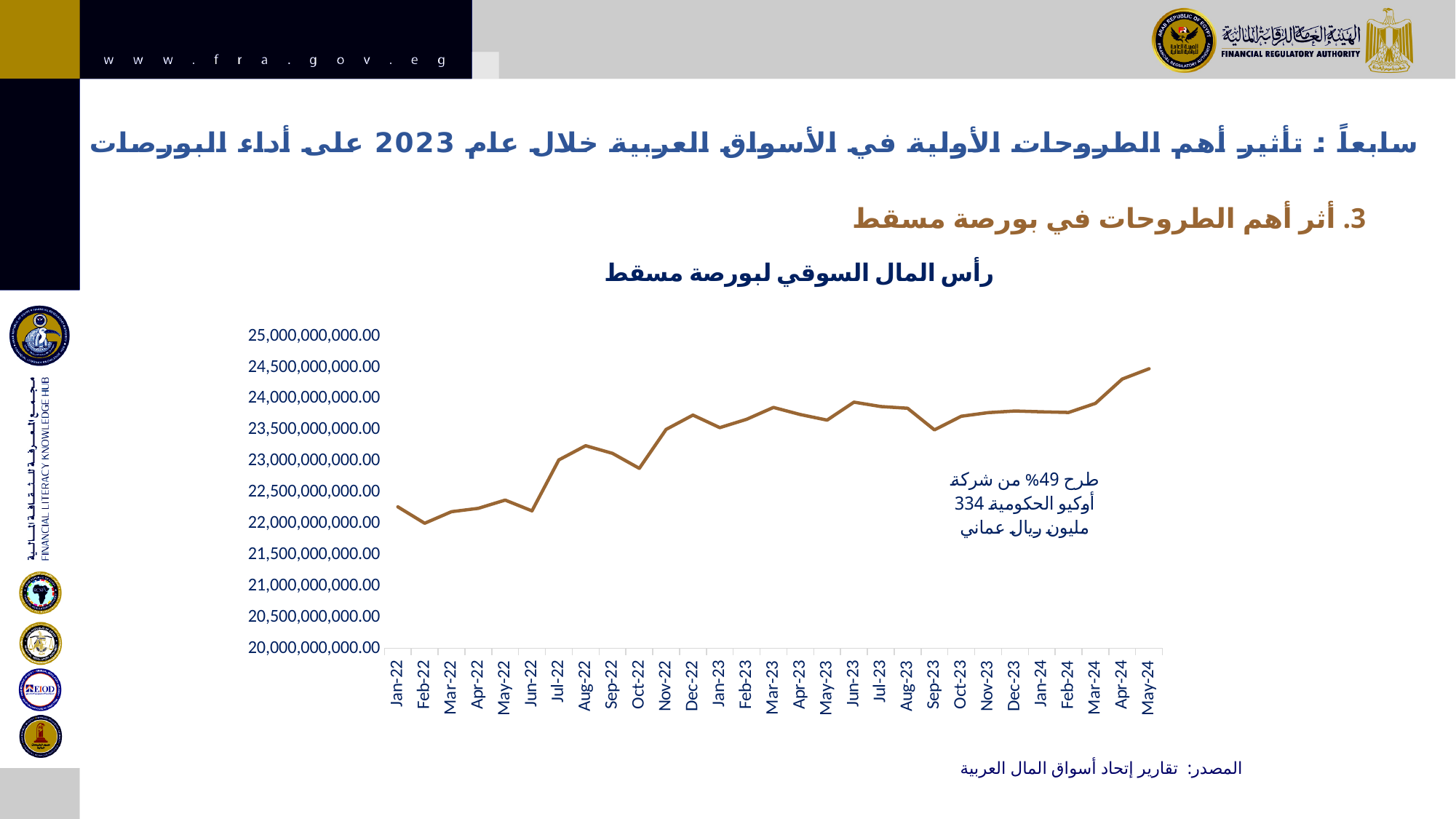
Which month has the larger value, Jun-22 or Jul-22? Jul-22 Is the value for Oct-22 greater or less than 23,000,000,000.00? less Overall, do the values rise or fall from Jan-22 to May-24? rise What is the title of the chart? رأس المال السوقي لبورصة مسقط What kind of chart is shown on the slide? line chart Is the value for Apr-24 greater or less than 24,000,000,000.00? greater What percentage of the OQ company offering is mentioned in the annotation on the chart? 49% Is the value for Jan-22 greater or less than 22,000,000,000.00? greater How many monthly data points are plotted on the chart? 29 Which month has the highest market capitalization on the chart? May-24 Which month has the lowest market capitalization on the chart? Feb-22